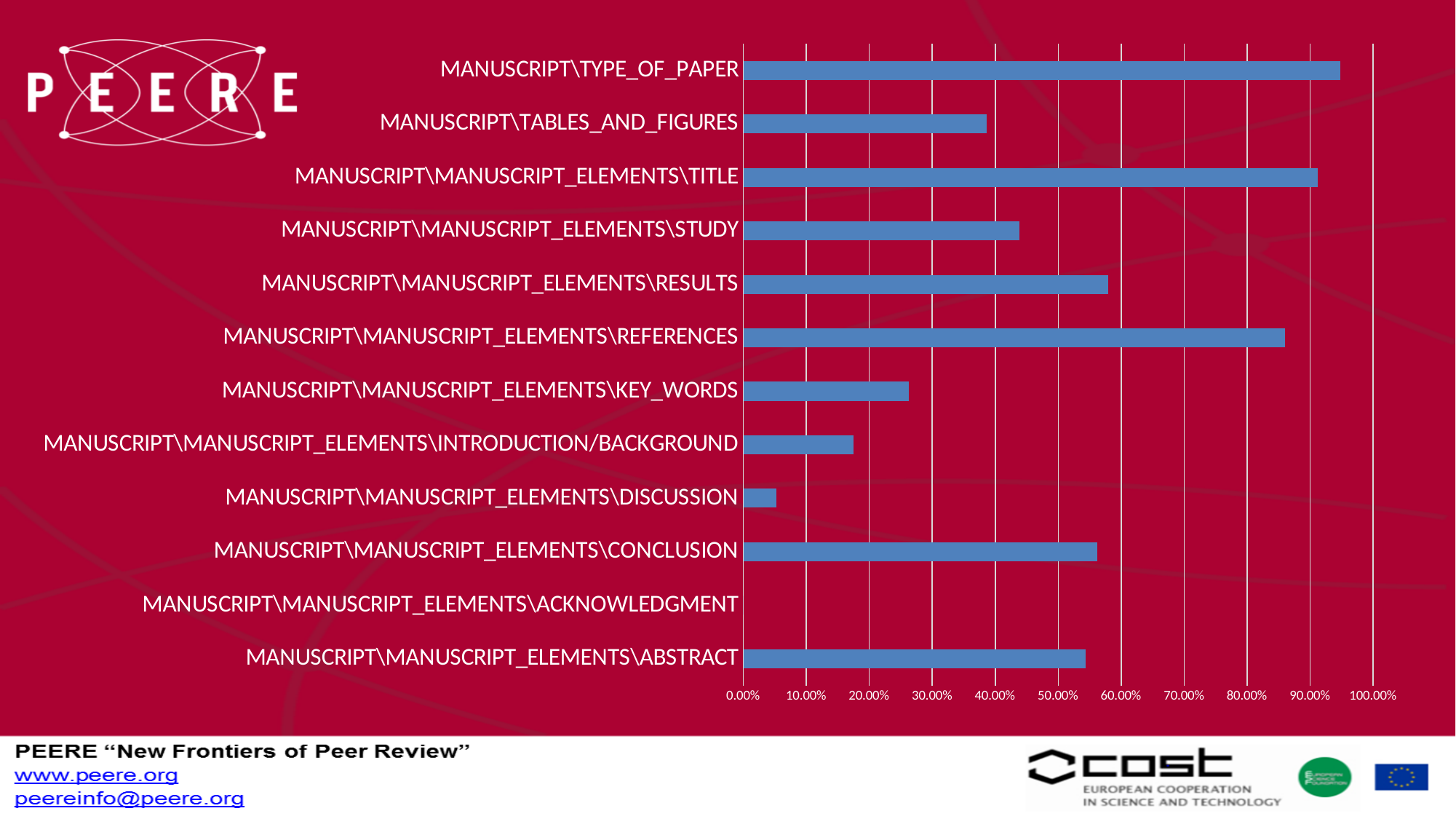
How many categories are listed on the chart's vertical axis? 12 Which category has no visible bar in the chart? MANUSCRIPT\MANUSCRIPT_ELEMENTS\ACKNOWLEDGMENT Is the value for MANUSCRIPT\MANUSCRIPT_ELEMENTS\CONCLUSION greater or less than 50.00%? greater Is the value for MANUSCRIPT\TYPE_OF_PAPER greater or less than 90.00%? greater Which category has the highest value in the chart? MANUSCRIPT\TYPE_OF_PAPER Is the value for MANUSCRIPT\MANUSCRIPT_ELEMENTS\REFERENCES greater or less than 80.00%? greater Which has the larger value: MANUSCRIPT\MANUSCRIPT_ELEMENTS\RESULTS or MANUSCRIPT\MANUSCRIPT_ELEMENTS\KEY_WORDS? MANUSCRIPT\MANUSCRIPT_ELEMENTS\RESULTS Which has the larger value: MANUSCRIPT\MANUSCRIPT_ELEMENTS\TITLE or MANUSCRIPT\MANUSCRIPT_ELEMENTS\REFERENCES? MANUSCRIPT\MANUSCRIPT_ELEMENTS\TITLE What kind of chart is shown on the slide? bar chart